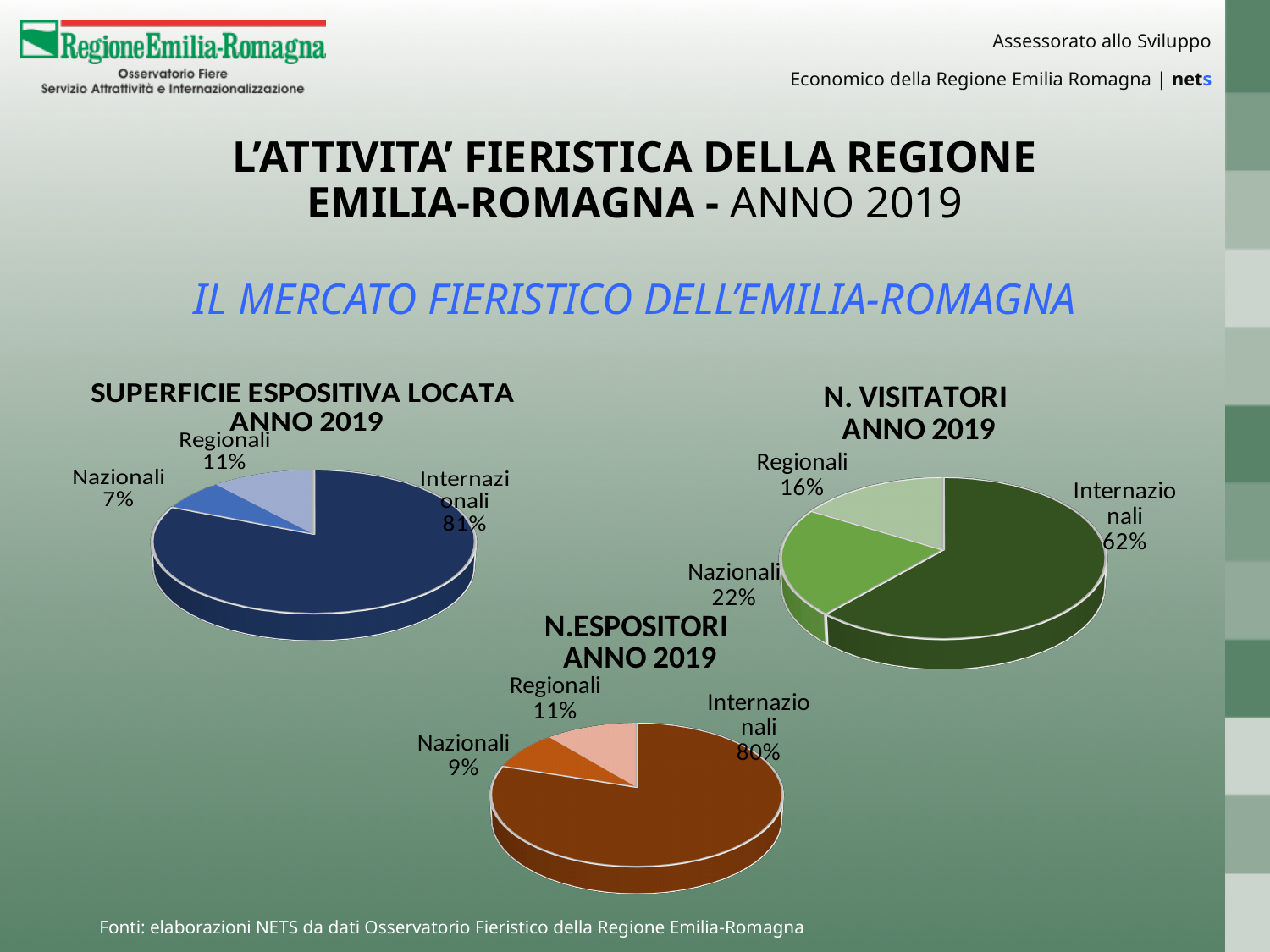
In the 'N.ESPOSITORI ANNO 2019' chart, which is larger, the Regionali slice or the Nazionali slice? Regionali In the 'SUPERFICIE ESPOSITIVA LOCATA ANNO 2019' chart, what share is labelled for Internazionali? 81% In the 'N. VISITATORI ANNO 2019' chart, what share is labelled for Regionali? 16% In the 'SUPERFICIE ESPOSITIVA LOCATA ANNO 2019' chart, what share is labelled for Nazionali? 7% What kind of chart is 'N. VISITATORI ANNO 2019'? Pie chart In the 'SUPERFICIE ESPOSITIVA LOCATA ANNO 2019' chart, which category has the smallest slice? Nazionali How many slices does the 'N.ESPOSITORI ANNO 2019' chart have? 3 In the 'N. VISITATORI ANNO 2019' chart, which category has the largest slice? Internazionali In the 'N. VISITATORI ANNO 2019' chart, what is the difference in percentage points between Internazionali and Nazionali? 40